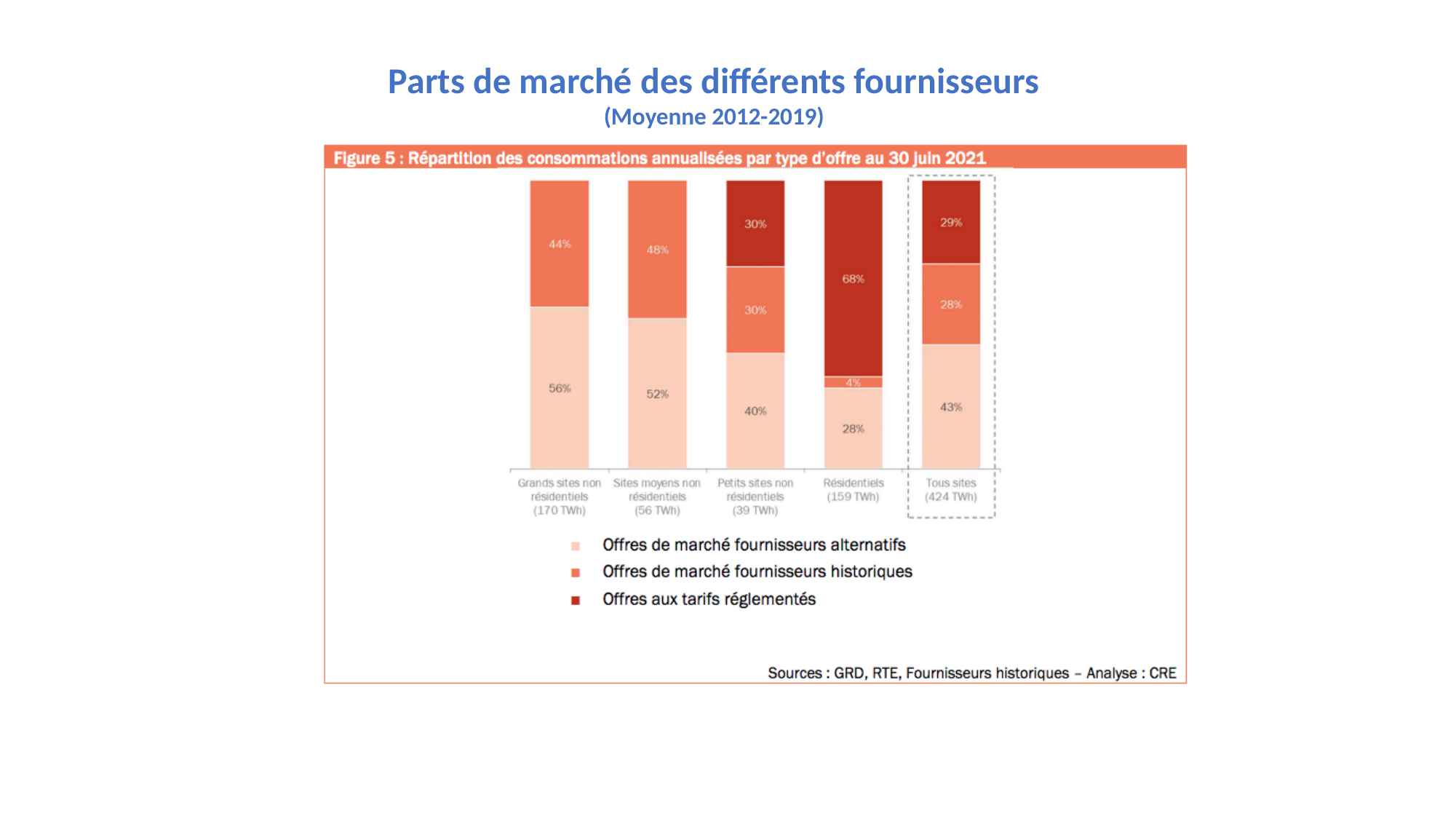
Which category has the highest share of 'Offres de marché fournisseurs alternatifs'? Grands sites non résidentiels What is the title of the figure shown on the slide? Figure 5 : Répartition des consommations annualisées par type d'offre au 30 juin 2021 What is the share of 'Offres de marché fournisseurs historiques' for 'Tous sites'? 28% What is the share of 'Offres aux tarifs réglementés' for 'Résidentiels'? 68% What kind of chart is shown on the slide? Stacked bar chart How many series does the legend list? 3 How many categories are shown along the x axis? 5 What is the difference between the 'Offres de marché fournisseurs alternatifs' share for 'Sites moyens non résidentiels' and for 'Petits sites non résidentiels'? 12% What is the total annualised consumption shown for 'Tous sites'? 424 TWh Which is larger: the 'Offres de marché fournisseurs historiques' share for 'Grands sites non résidentiels' or for 'Sites moyens non résidentiels'? Sites moyens non résidentiels What is the share of 'Offres de marché fournisseurs alternatifs' for 'Grands sites non résidentiels'? 56% Which category has the lowest share of 'Offres de marché fournisseurs historiques'? Résidentiels